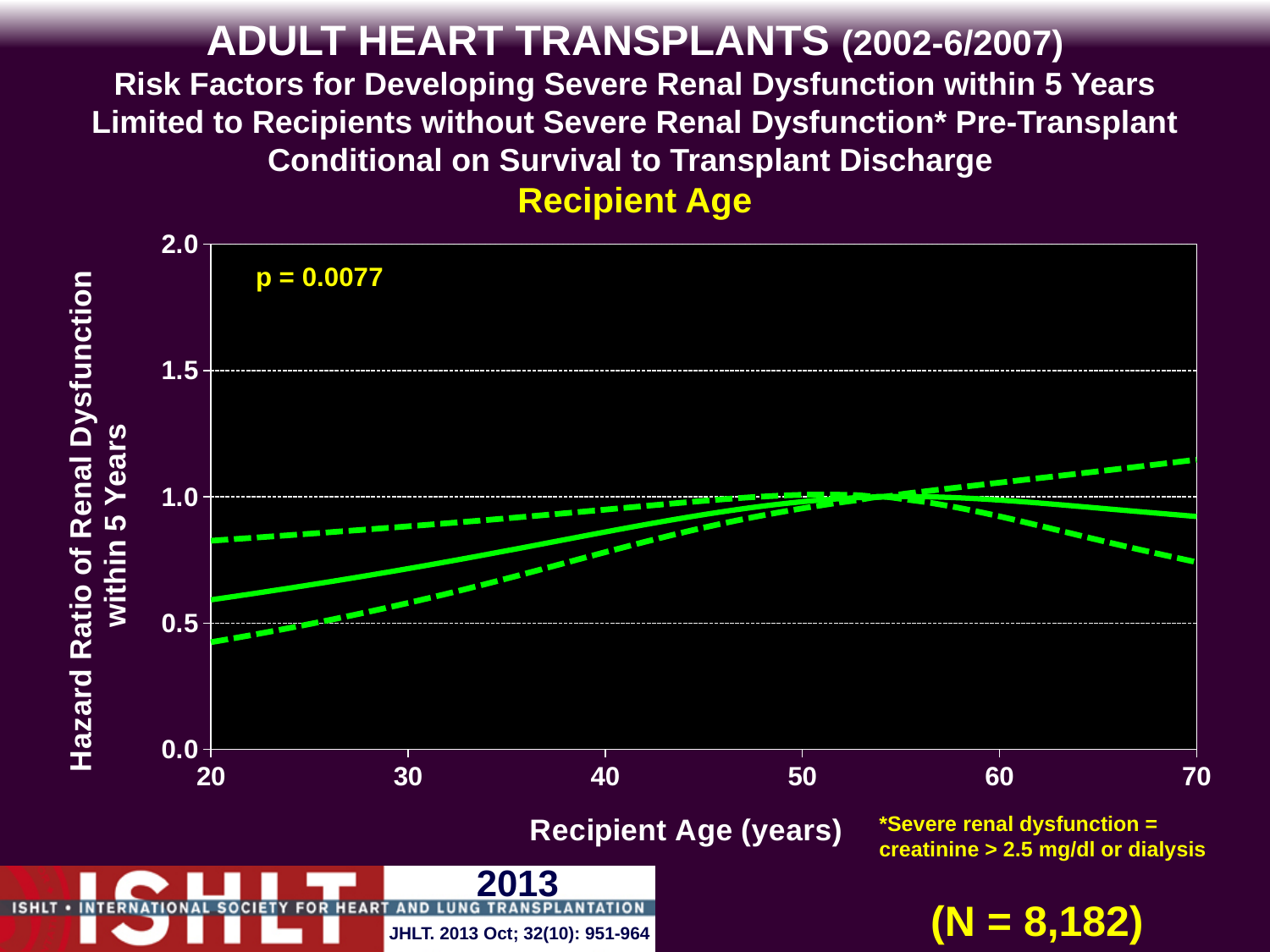
Is the hazard ratio (solid line) at recipient age 70 greater or less than 1.0? less Is the hazard ratio (solid line) higher at recipient age 50 or at recipient age 20? age 50 What kind of chart is shown on the slide? line chart Is the lower dashed line at recipient age 20 greater or less than 0.5? less What is the p-value printed on the chart? p = 0.0077 Is the hazard ratio (solid line) at recipient age 20 greater or less than 0.5? greater What is the highest value shown on the y axis? 2.0 Does the hazard ratio (solid line) rise or fall between recipient age 20 and recipient age 50? rise What is the label of the x axis? Recipient Age (years)